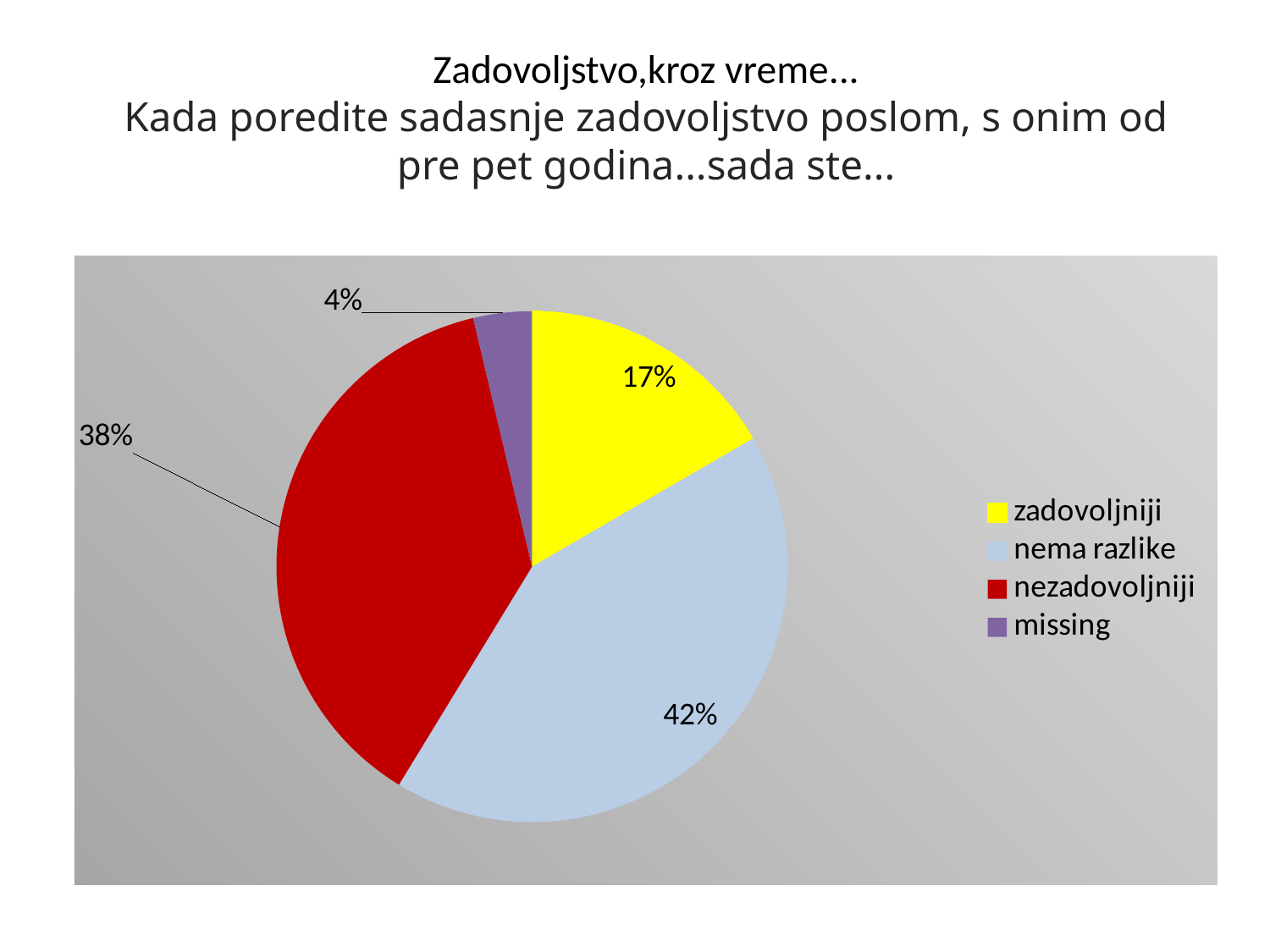
What is the difference in percentage points between "nezadovoljniji" and "zadovoljniji"? 21 Which category has the smallest slice of the pie? missing Which category has the largest slice of the pie? nema razlike What share of the pie is labelled "nezadovoljniji"? 38% What is the difference in percentage points between "nema razlike" and "nezadovoljniji"? 4 Which is larger, the slice for "zadovoljniji" or the slice for "nezadovoljniji"? nezadovoljniji What share of the pie is labelled "zadovoljniji"? 17% What share of the pie is labelled "missing"? 4% How many categories does the legend list? 4 What colour is the slice for "nezadovoljniji"? red What kind of chart is shown on the slide? pie chart